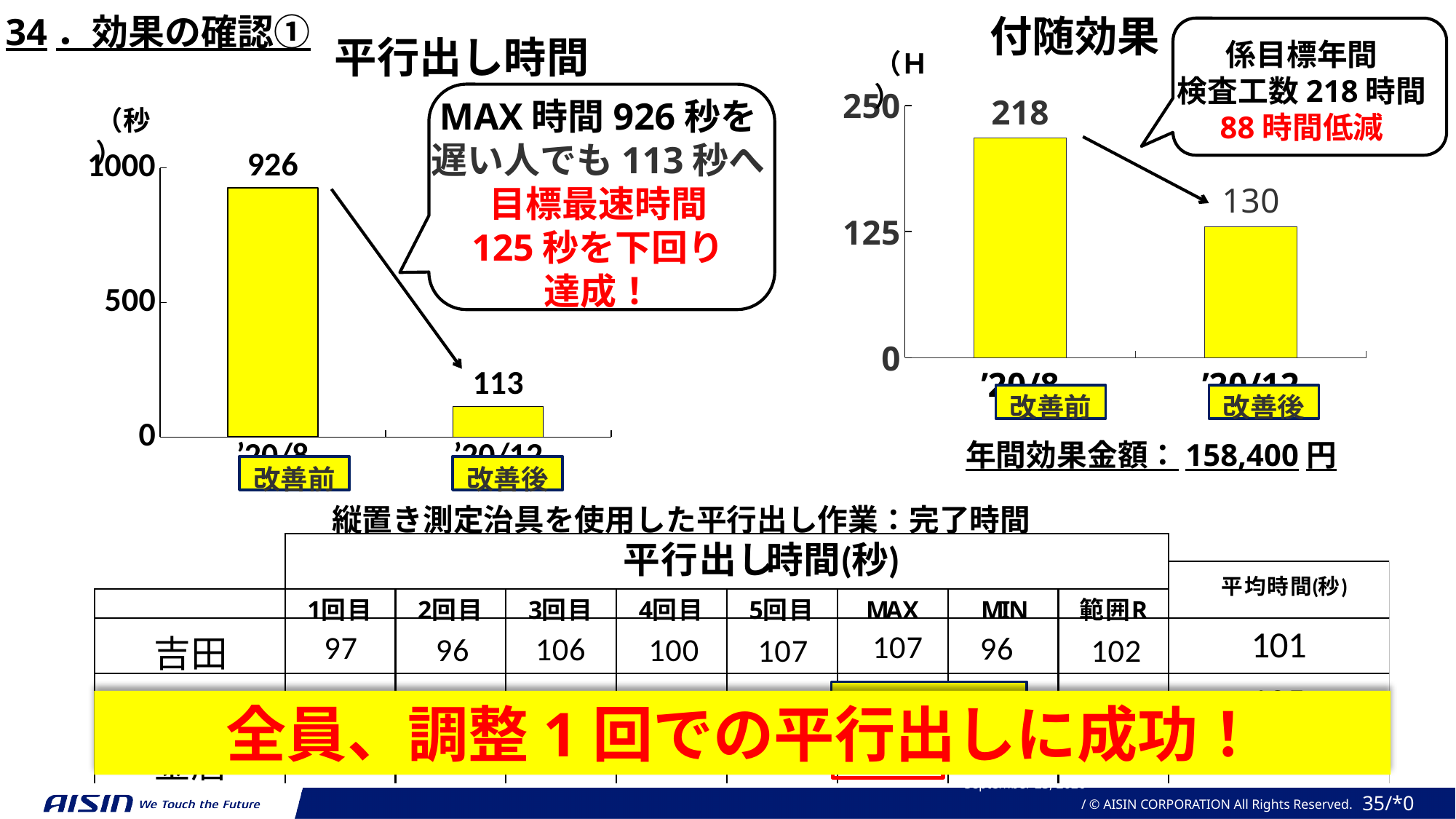
In the 付随効果 chart on the right, is the value for '20/12 greater or less than 125? greater How many bars are plotted in the 付随効果 chart on the right? 2 In the 平行出し時間 chart on the left, what is the difference between the '20/8 and '20/12 values? 813 In the 平行出し時間 chart on the left, which category has the lowest value? '20/12 (改善後) What kind of chart is the 平行出し時間 chart on the left? bar chart In the 平行出し時間 chart on the left, what is the value for '20/8 (改善前)? 926 In the 平行出し時間 chart on the left, what is the value for '20/12 (改善後)? 113 In the 平行出し時間 chart on the left, do the values rise or fall from '20/8 to '20/12? fall In the 付随効果 chart on the right, what is the value for '20/8 (改善前)? 218 In the 付随効果 chart on the right, which category has the highest value? '20/8 (改善前) In the 付随効果 chart on the right, what is the value for '20/12 (改善後)? 130 In the 付随効果 chart on the right, what is the difference between the '20/8 and '20/12 values? 88